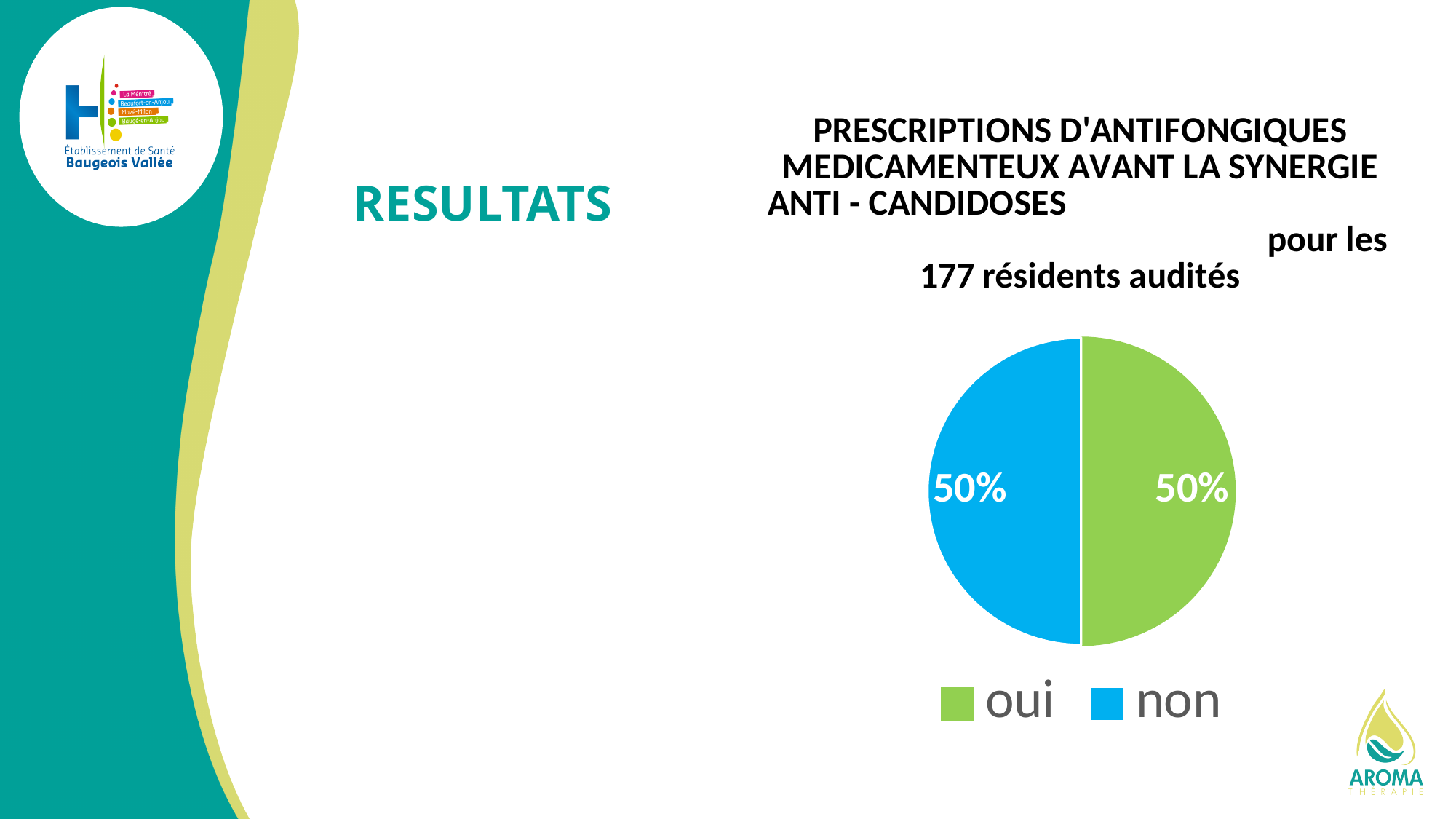
How many residents were audited according to the chart title? 177 What is the total of the two slices shown on the pie chart? 100% What share of the pie does the "non" slice represent? 50% How many entries does the legend list? 2 How many slices does the pie chart have? 2 What is the difference between the "oui" and "non" shares? 0% Which colour represents "non" in the pie chart? blue What share of the pie does the "oui" slice represent? 50% What kind of chart is shown on the slide? pie chart Which colour represents "oui" in the pie chart? green